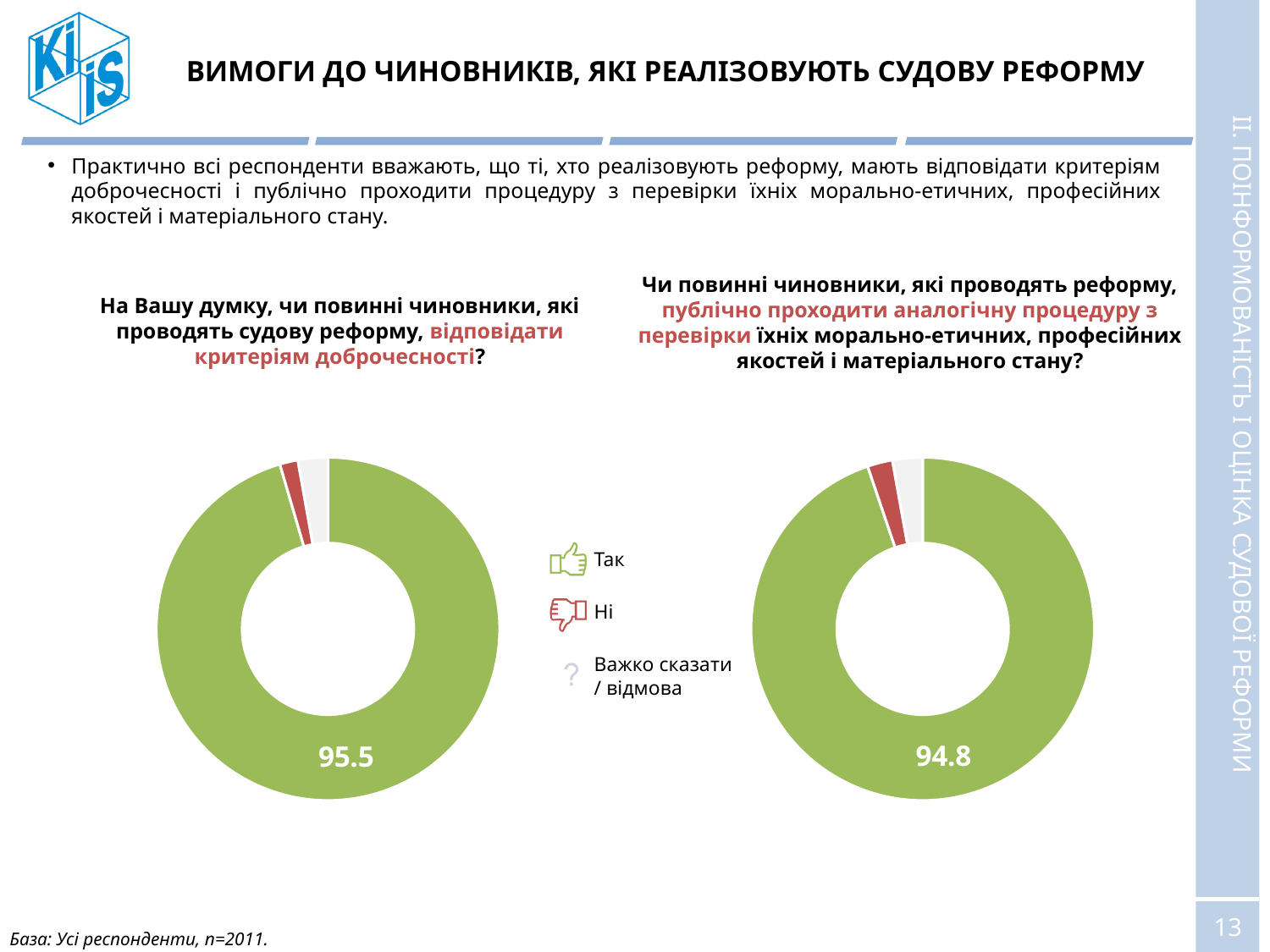
In the left donut chart (about відповідати критеріям доброчесності), what percentage of respondents answered "Так"? 95.5 What colour represents the "Так" answer in the charts? green In the left chart, which answer category has the largest share? Так In the left chart, is the share of "Так" answers greater or less than 90? greater What type of chart is used on this slide? donut (pie) chart What is the difference between the "Так" share in the left chart (95.5) and in the right chart (94.8)? 0.7 How many answer categories does the legend list? 3 Which chart shows a higher share of "Так" answers: the left chart or the right chart? the left chart What colour represents the "Ні" answer in the charts? red How many slices does each donut chart contain? 3 In the right donut chart (about публічно проходити аналогічну процедуру з перевірки), what percentage of respondents answered "Так"? 94.8 In the right chart, which answer category has the largest share? Так